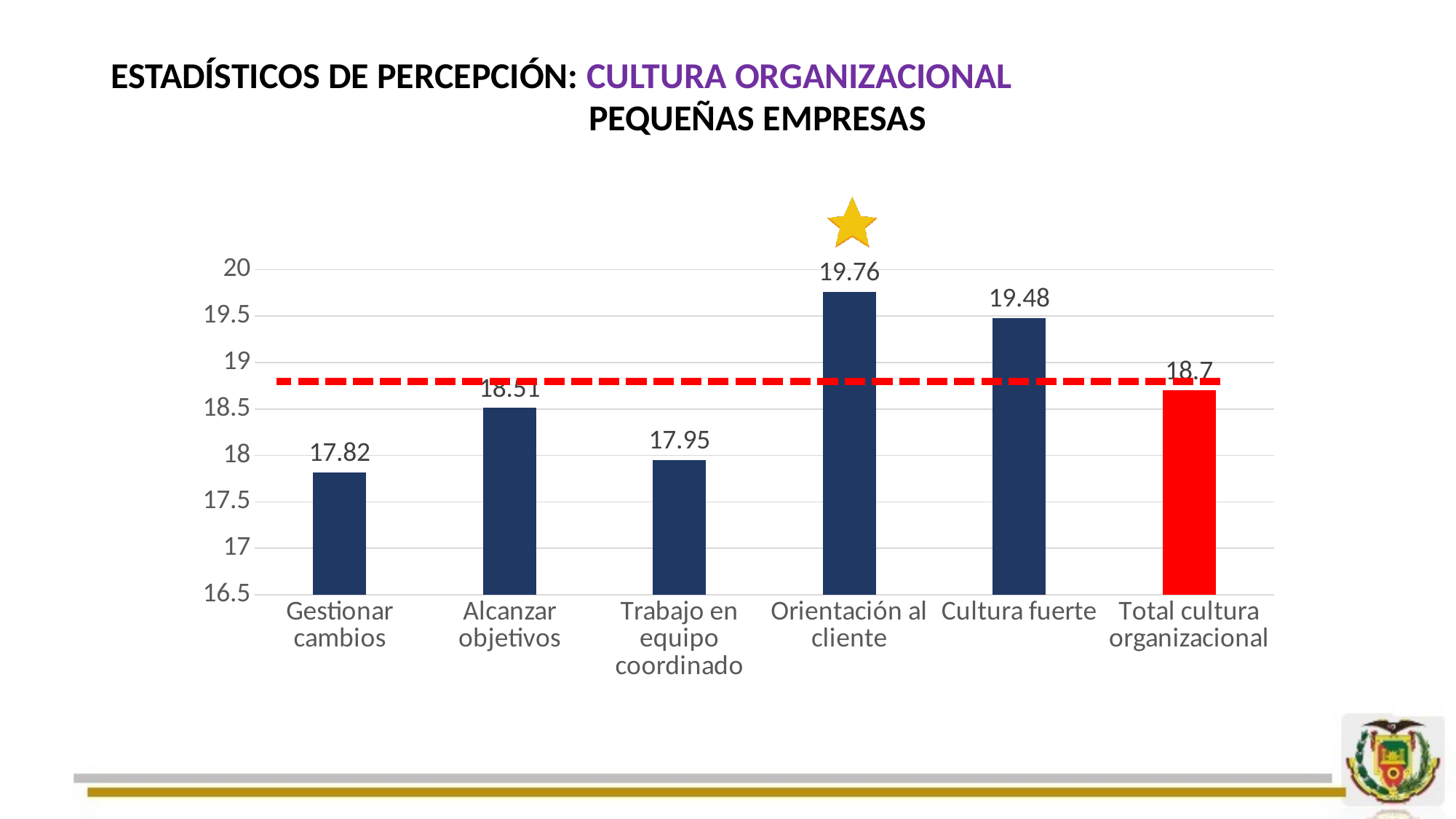
What is the value for Total cultura organizacional? 18.7 Which bar is coloured red instead of dark blue? Total cultura organizacional What kind of chart is this? Bar chart Which is larger, Cultura fuerte or Alcanzar objetivos? Cultura fuerte How many categories are shown on the x axis? 6 What is the value for Gestionar cambios? 17.82 Which category has the lowest value? Gestionar cambios What is the value for Orientación al cliente? 19.76 What is the value for Trabajo en equipo coordinado? 17.95 What is the difference between Alcanzar objetivos and Gestionar cambios? 0.69 What is the difference between Orientación al cliente and Cultura fuerte? 0.28 Which category has the highest value? Orientación al cliente